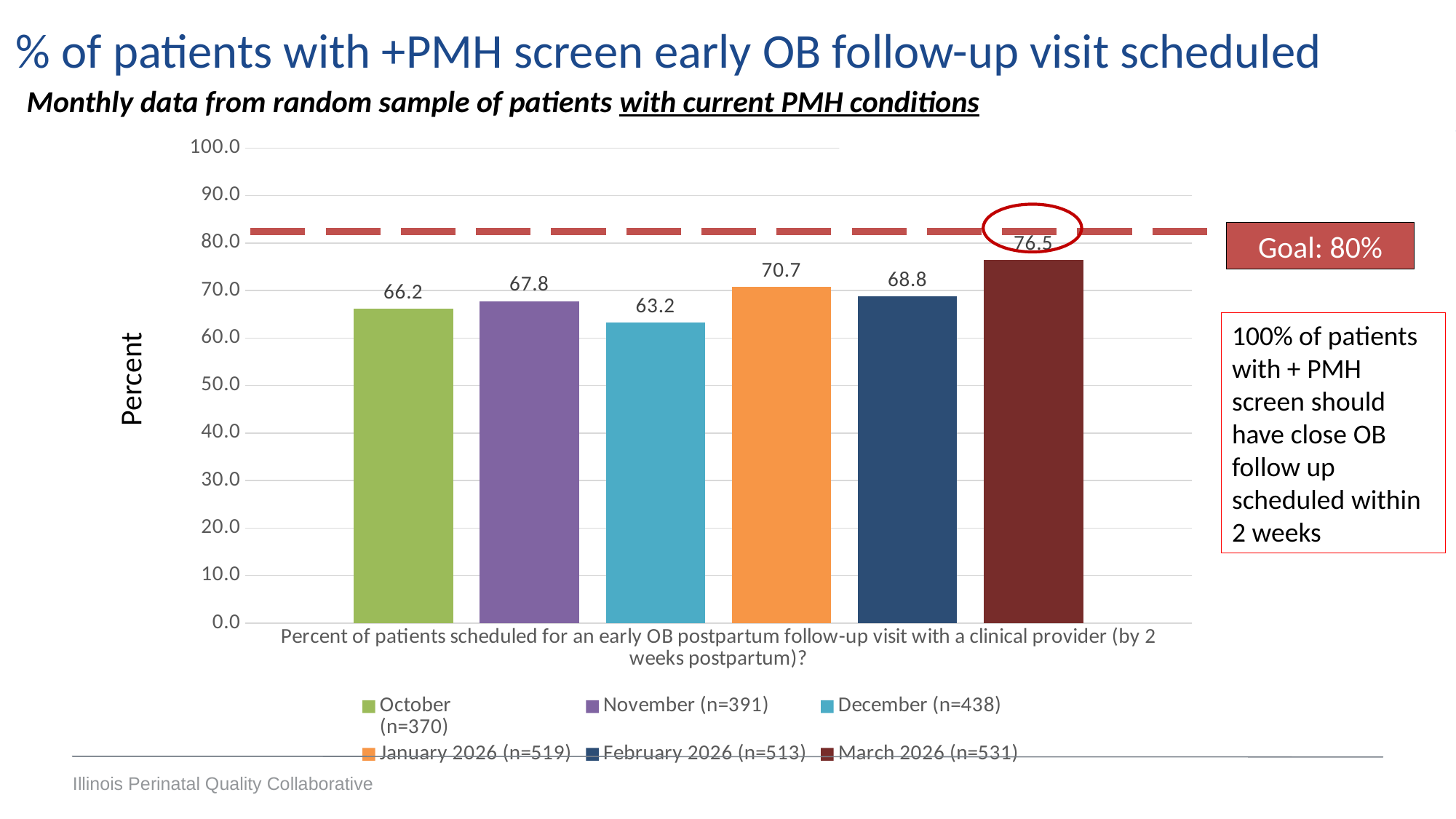
What is the value for March 2026 (n=531)? 76.5 How many series does the legend list? 6 What is the value for October (n=370)? 66.2 Which month has the lowest value? December (n=438) What goal value is shown by the dashed line? 80% What is the value for December (n=438)? 63.2 Which month has the highest value? March 2026 (n=531) What kind of chart is shown? bar chart What is the difference between the values for March 2026 and December? 13.3 What is the label of the y axis? Percent Which is larger, the value for January 2026 or the value for February 2026? January 2026 Is the value for March 2026 greater or less than 80? less